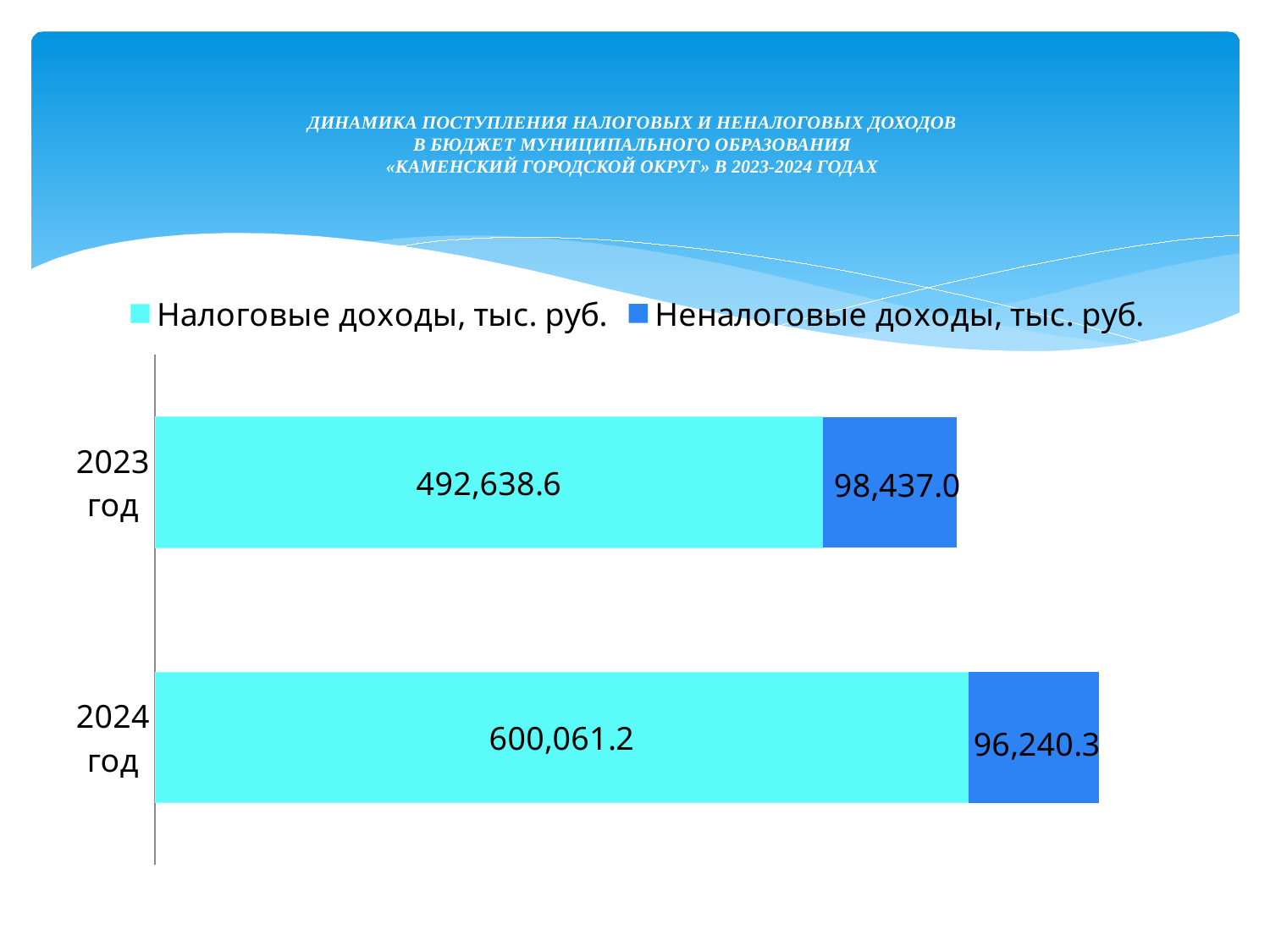
How many categories (years) are shown on the chart? 2 Which year has the lower value of Неналоговые доходы, тыс. руб.? 2024 год Do Налоговые доходы, тыс. руб. rise or fall from 2023 год to 2024 год? Rise Which colour represents Неналоговые доходы, тыс. руб. in the legend? Blue What is the value of Неналоговые доходы, тыс. руб. for 2023 год? 98,437.0 By how much did Налоговые доходы, тыс. руб. increase from 2023 год to 2024 год? 107,422.6 What is the value of Неналоговые доходы, тыс. руб. for 2024 год? 96,240.3 Which year has the higher value of Налоговые доходы, тыс. руб.? 2024 год What is the value of Налоговые доходы, тыс. руб. for 2023 год? 492,638.6 How many series does the legend list? 2 What type of chart is shown on the slide? Stacked bar chart What is the total of the stacked bar for 2024 год? 696,301.5